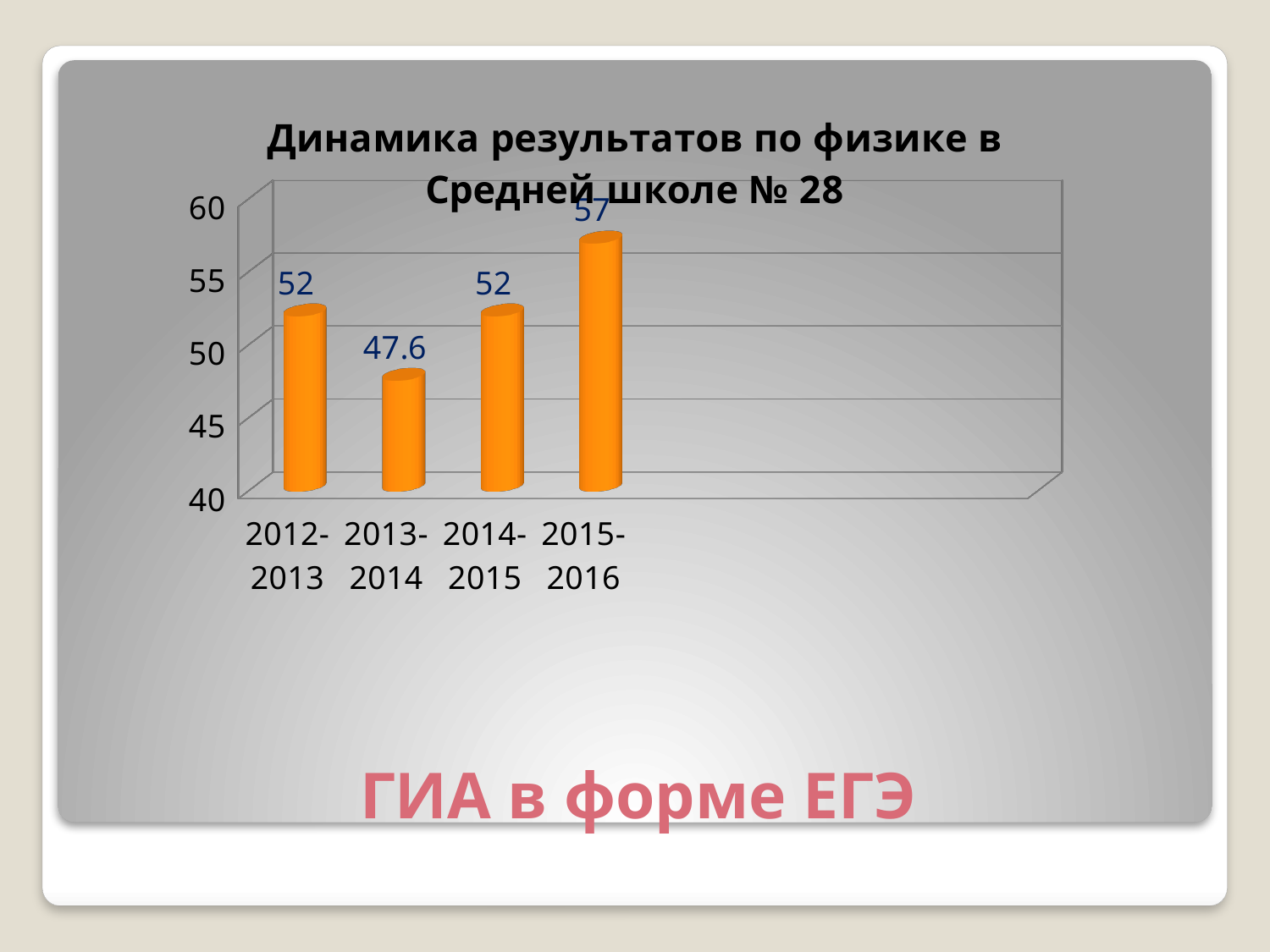
What is the value for 2013-2014? 47.6 How many school years are shown on the chart? 4 Which is larger, the value for 2013-2014 or the value for 2014-2015? 2014-2015 Is the value for 2013-2014 greater or less than 50? less What is the value for 2012-2013? 52 Which school year has the lowest value? 2013-2014 What is the value for 2015-2016? 57 What is the title of the chart? Динамика результатов по физике в Средней школе № 28 What kind of chart is shown on the slide? bar chart What is the difference between the values for 2015-2016 and 2013-2014? 9.4 What is the difference between the values for 2015-2016 and 2014-2015? 5 Which school year has the highest value? 2015-2016